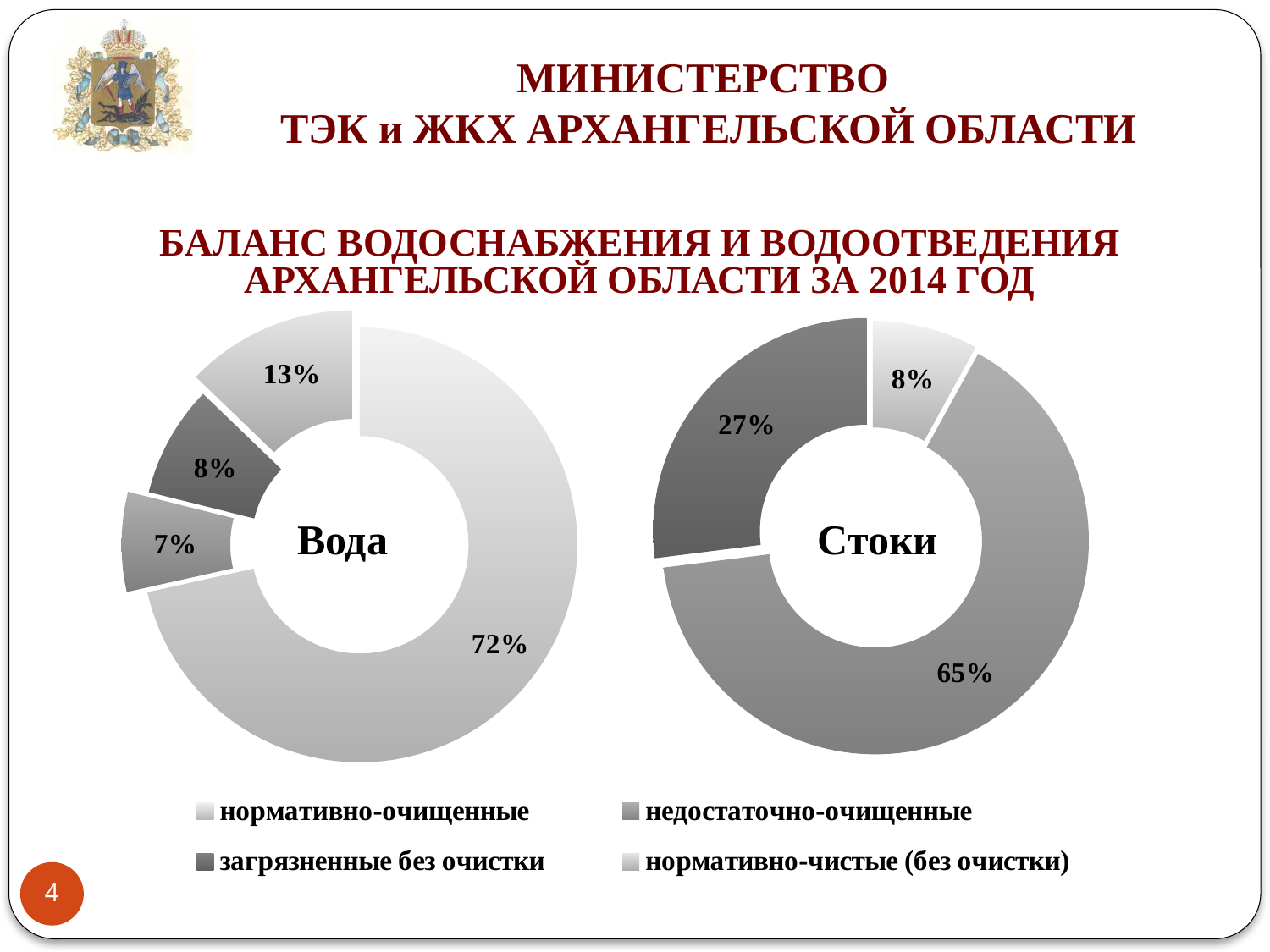
In the "Стоки" chart, what share is labelled for the "недостаточно-очищенные" slice? 65% How many slices does the "Вода" chart have? 4 In the "Стоки" chart, what share is labelled for the "загрязненные без очистки" slice? 27% In the "Вода" chart, what is the largest slice's value? 72% How many entries does the legend list? 4 How many slices does the "Стоки" chart have? 3 In the "Стоки" chart, what is the largest slice's value? 65% What is the difference between the largest slices of the "Вода" chart (72%) and the "Стоки" chart (65%)? 7 percentage points In the "Стоки" chart, what is the smallest slice's value? 8% In the "Вода" chart, what is the smallest slice's value? 7% In the "Вода" chart, what share is labelled for the "нормативно-очищенные" slice? 72% What kind of charts are shown on the slide? Doughnut (pie) charts